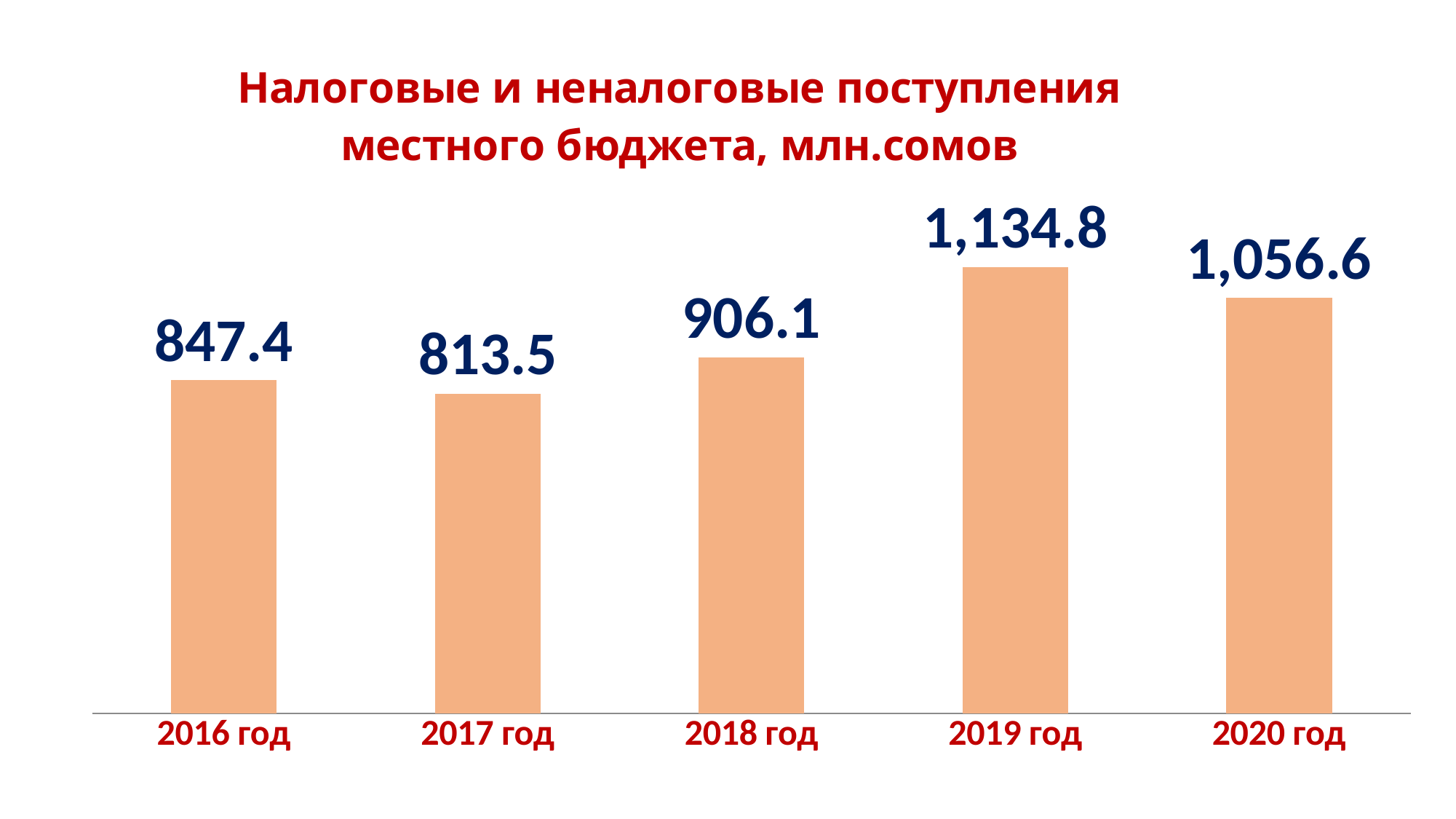
Which year has the lowest value? 2017 год What is the value for 2019 год? 1,134.8 What is the value for 2018 год? 906.1 What is the value for 2016 год? 847.4 Which is larger, the value for 2018 год or the value for 2016 год? 2018 год What is the difference between the values for 2016 год and 2017 год? 33.9 What is the value for 2017 год? 813.5 What is the difference between the values for 2019 год and 2020 год? 78.2 Which year has the highest value? 2019 год What is the value for 2020 год? 1,056.6 What kind of chart is this? bar chart How many years are shown on the chart? 5